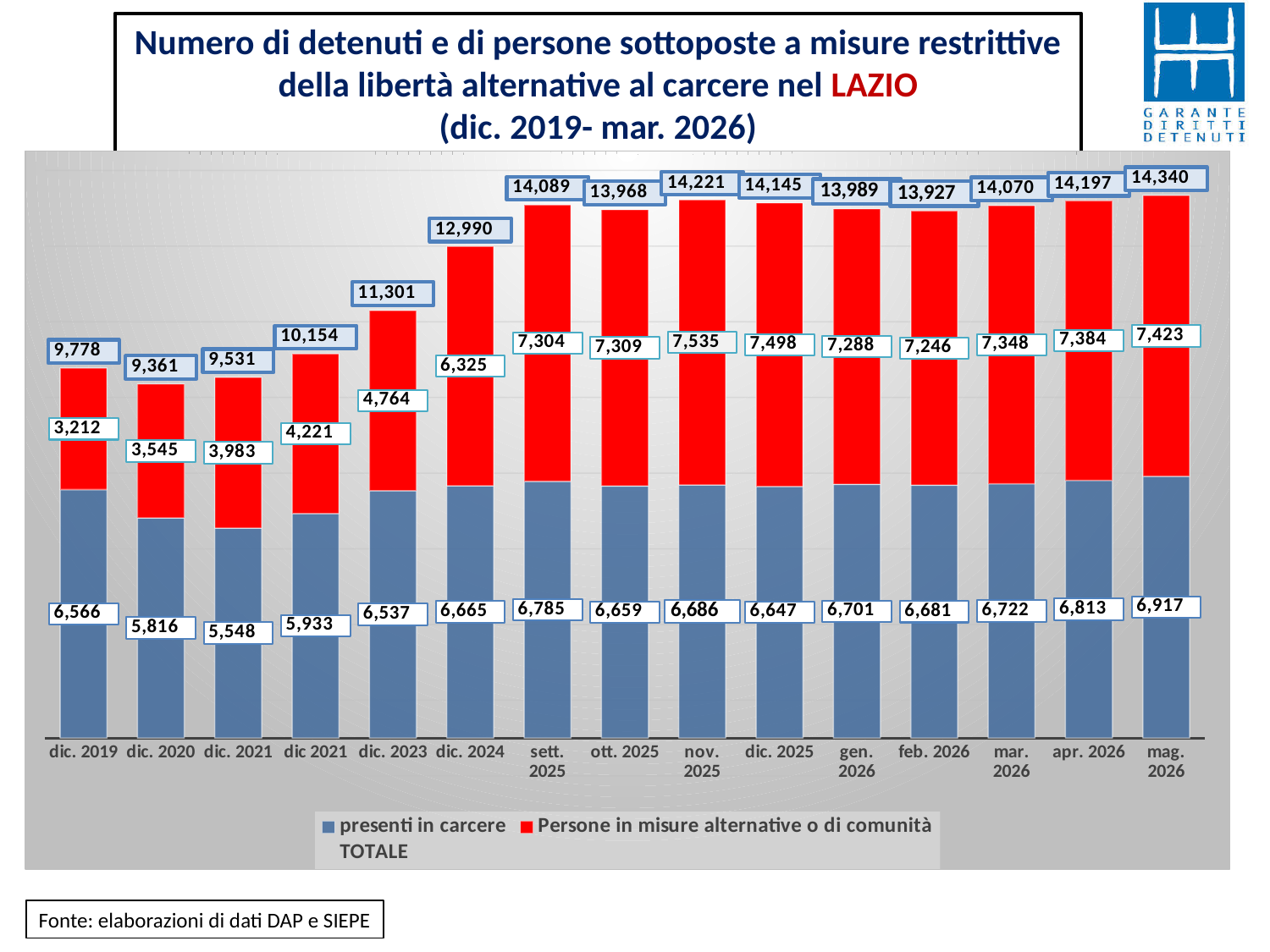
How many periods are shown on the x axis? 15 What is the TOTALE value shown for nov. 2025? 14,221 How many entries does the legend list? 3 Which period has the highest TOTALE value? mag. 2026 Does the TOTALE value rise or fall from dic. 2020 to dic. 2024? Rise What is the difference between the 'presenti in carcere' values for mag. 2026 and dic. 2019? 351 Which period has the lowest TOTALE value? dic. 2020 What is the value for 'Persone in misure alternative o di comunità' in mag. 2026? 7,423 What is the value for 'presenti in carcere' in dic. 2019? 6,566 What kind of chart is shown on the slide? Stacked bar chart Which colour represents 'Persone in misure alternative o di comunità'? Red Which is larger in dic. 2024: 'presenti in carcere' or 'Persone in misure alternative o di comunità'? presenti in carcere